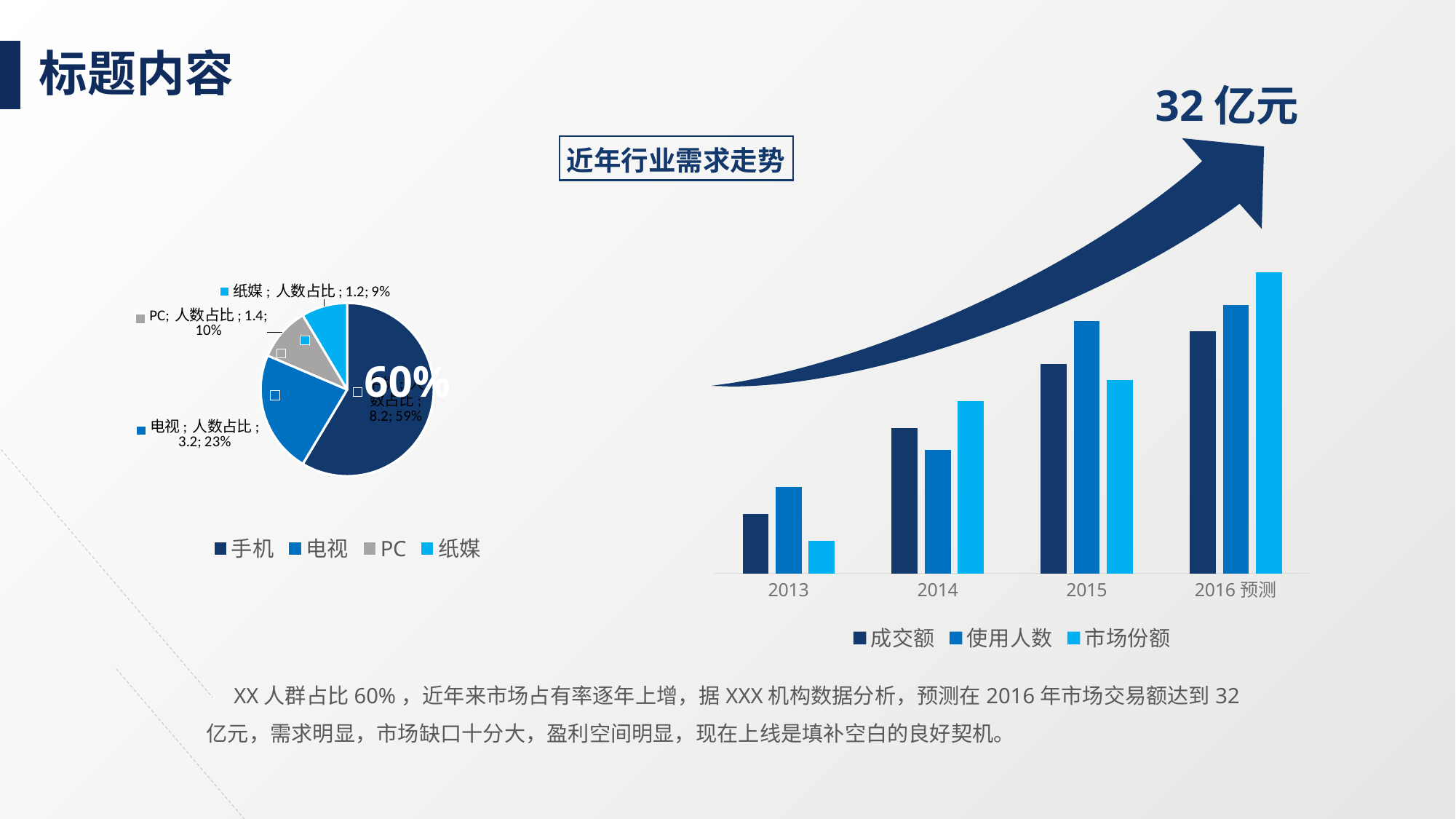
In the chart titled 近年行业需求走势, which series has the tallest bar for 2016 预测? 市场份额 In the pie chart on the left, which category has the smallest slice? 纸媒 In the pie chart on the left, what is the value for 手机? 8.2 In the chart titled 近年行业需求走势, does 成交额 rise or fall from 2013 to 2016 预测? rise What kind of chart is the chart on the left of the slide? pie chart In the pie chart on the left, how many categories does the legend list? 4 What kind of chart is the chart titled 近年行业需求走势? bar chart In the pie chart on the left, what is the value for 纸媒? 1.2 In the pie chart on the left, what share does PC have? 10% In the chart titled 近年行业需求走势, how many series does the legend list? 3 In the chart titled 近年行业需求走势, how many categories are shown on the x axis? 4 In the pie chart on the left, what share does 电视 have? 23%